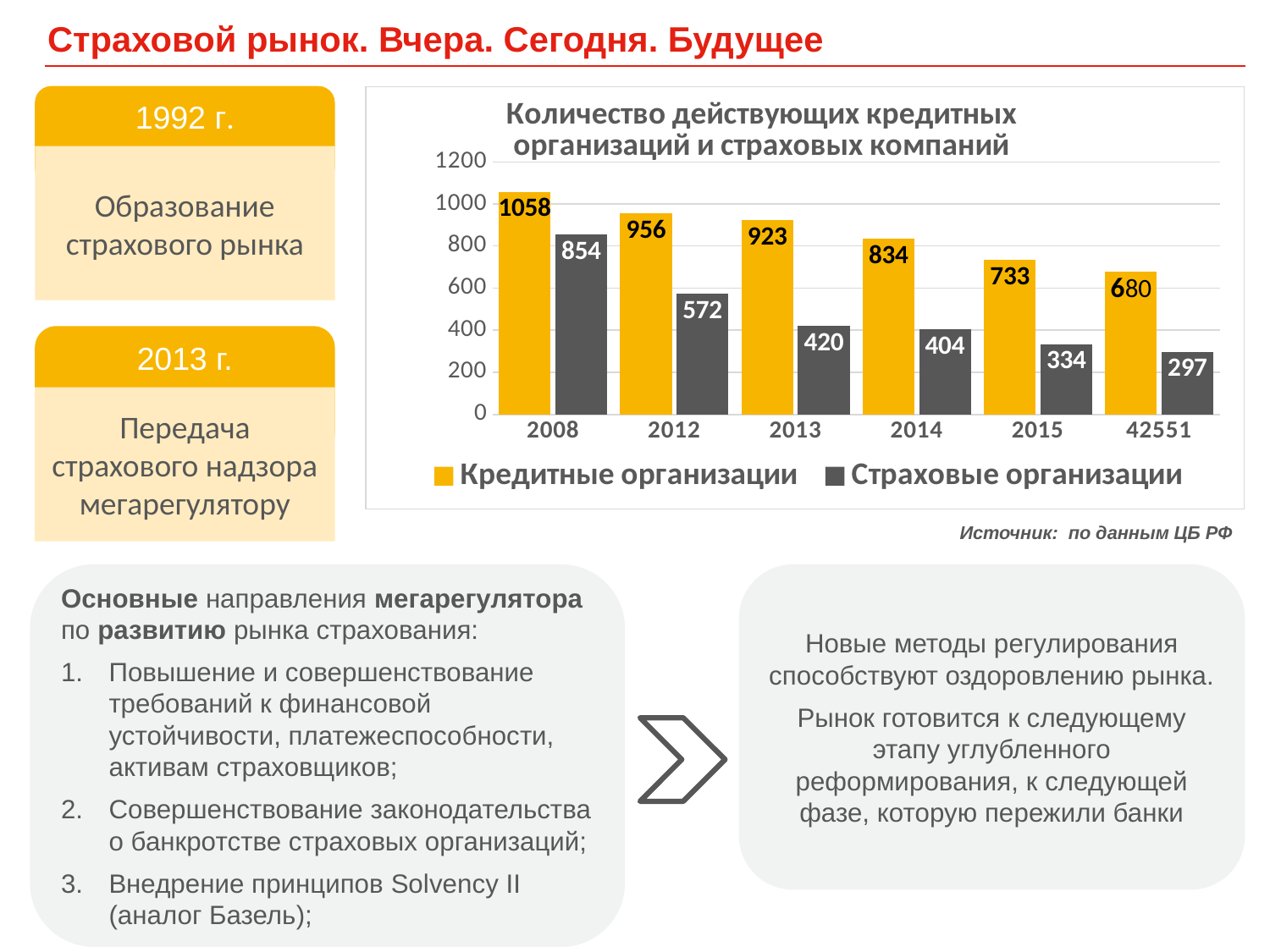
На сколько уменьшилось количество страховых организаций с 2008 по 2014 год? 450 Какое значение для страховых организаций указано за 2013 год? 420 Какого типа эта диаграмма? Столбчатая (bar chart) В каком году количество кредитных организаций было наибольшим? 2008 На сколько количество кредитных организаций в 2012 году больше количества страховых организаций в том же году? 384 Сколько рядов данных перечислено в легенде диаграммы? 2 Сколько страховых организаций показано за 2015 год? 334 Что больше: количество кредитных организаций в 2015 году или количество страховых организаций в 2008 году? Страховые организации в 2008 году Как изменяется количество кредитных организаций слева направо по оси x? Уменьшается Сколько категорий (подписей по оси x) показано на диаграмме? 6 Для какой категории на оси x значение страховых организаций наименьшее? 42551 Сколько кредитных организаций показано на диаграмме за 2008 год? 1058